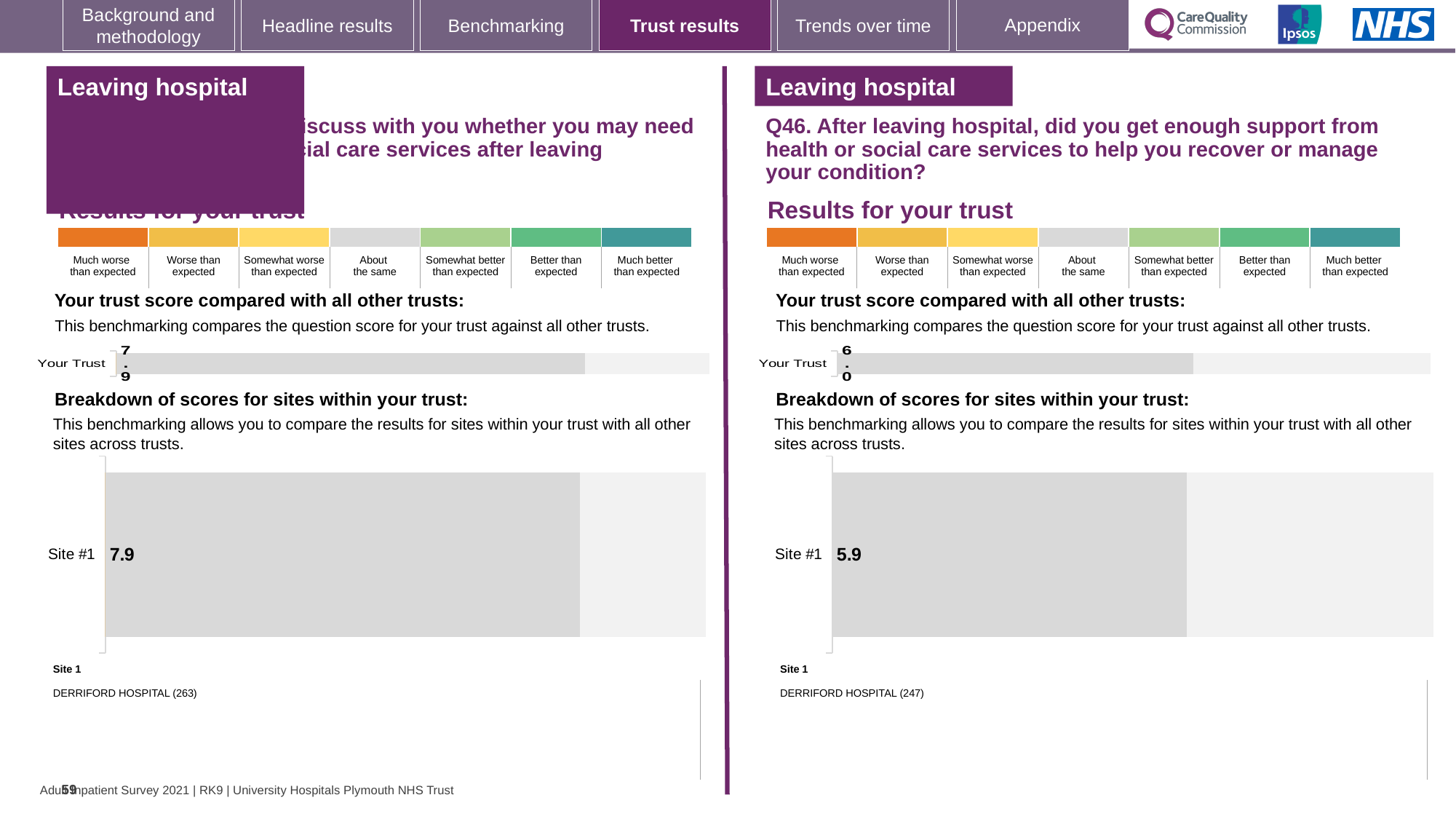
What is the difference between the trust score on the left half of the slide and the trust score on the right half (Q46)? 1.9 How many sites are shown in the 'Breakdown of scores for sites within your trust' chart on the right half of the slide? 1 Which is larger: the Site #1 score in the left-hand breakdown chart or the Site #1 score in the right-hand (Q46) breakdown chart? Left-hand chart (7.9) On the right half of the slide (Q46), is the trust score greater or less than the Site #1 score? greater What kind of chart is used to show the Site #1 score in the breakdown section on the left half of the slide? Bar chart On the right half of the slide (Q46), what score is shown for Site #1 in the 'Breakdown of scores for sites within your trust' chart? 5.9 What is the difference between the Site #1 score on the left half of the slide and the Site #1 score on the right half (Q46)? 2.0 On the right half of the slide (Q46), what is the trust score shown in the 'Your trust score compared with all other trusts' chart? 6.0 On the left half of the slide, what score is shown for Site #1 in the 'Breakdown of scores for sites within your trust' chart? 7.9 On the left half of the slide, what is the trust score shown in the 'Your trust score compared with all other trusts' chart? 7.9 What is the name of the site labelled Site 1 on the right half of the slide? DERRIFORD HOSPITAL (247) What is the name of the site labelled Site 1 on the left half of the slide? DERRIFORD HOSPITAL (263)